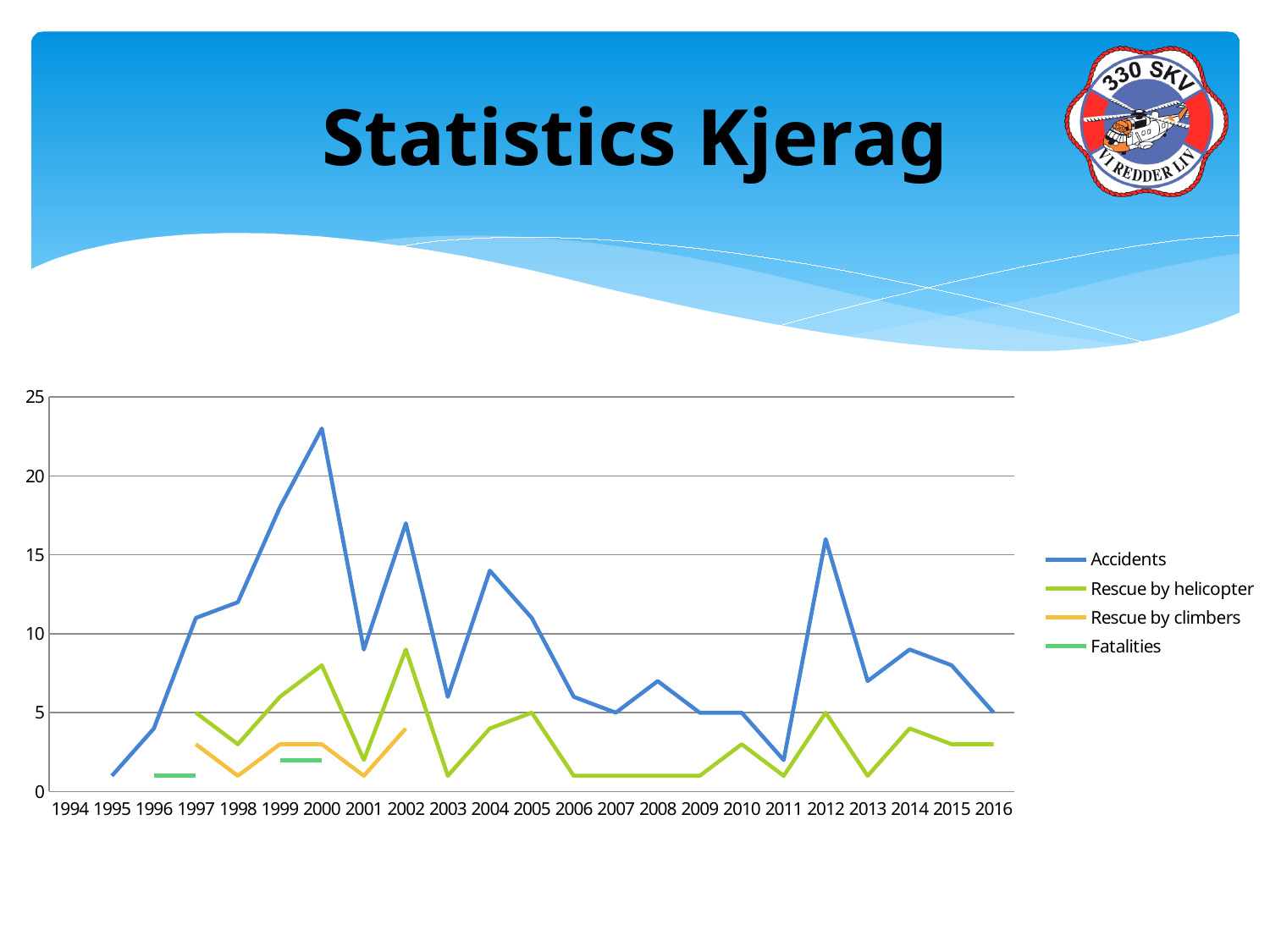
Which is larger, the Accidents value in 2000 or in 2002? 2000 Which series is drawn in green in the legend? Fatalities Is the value for Accidents in 2000 greater or less than 20? greater In which year does the Accidents series reach its highest value? 2000 Is the value for Accidents in 2011 greater or less than 5? less Is the value for Accidents in 2012 greater or less than 15? greater Do the Accidents values rise or fall from 1995 to 2000? rise In which year does the Rescue by helicopter series reach its highest value? 2002 What kind of chart is shown on the slide? line chart How many series does the legend list? 4 What is the value for Accidents in 2016? 5 How many years are shown along the x axis? 23